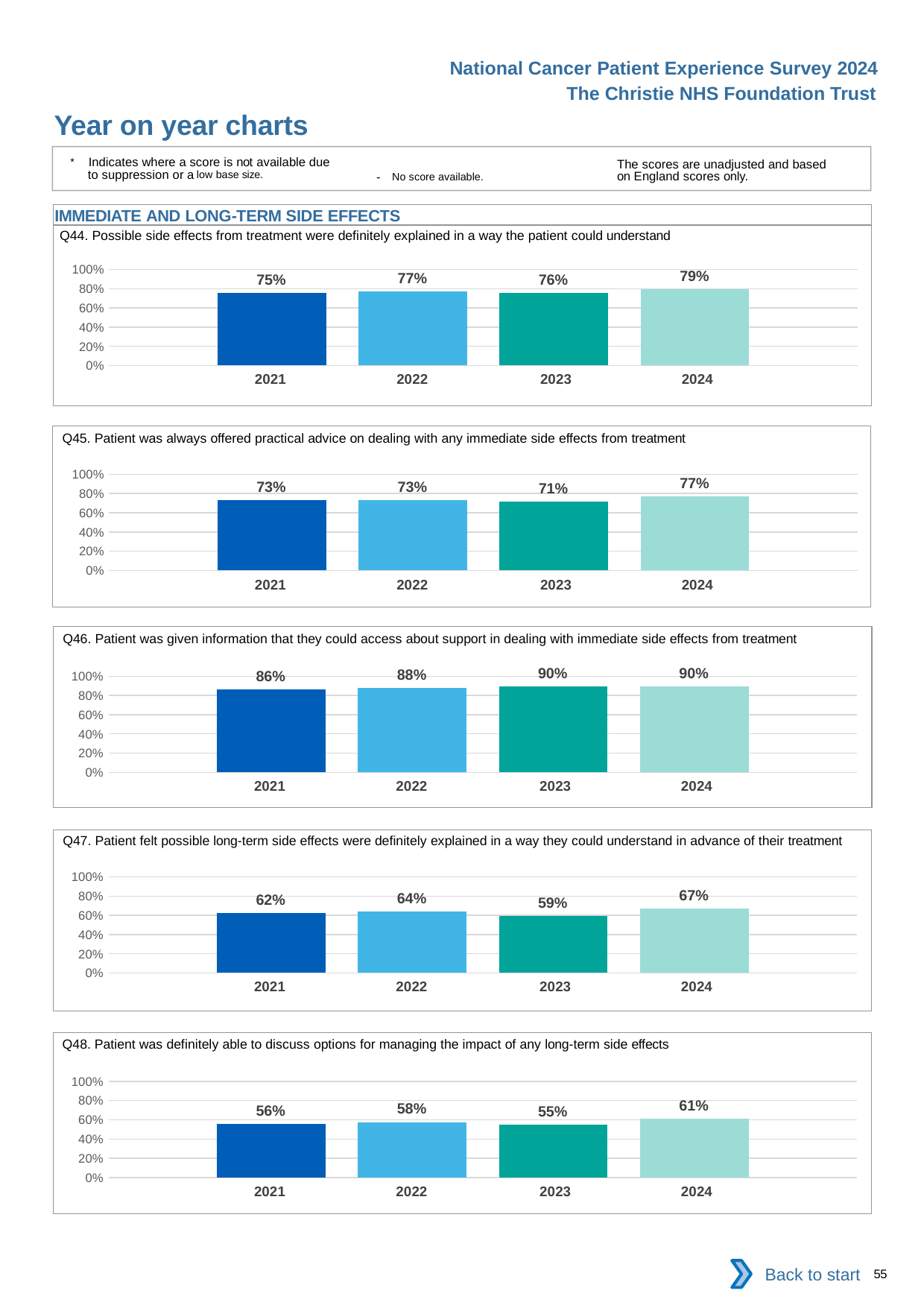
In the Q46 chart, is the value for 2021 greater or less than 80%? greater In the Q44 chart, what is the value for 2024? 79% How many years are shown in the Q44 chart? 4 In the Q45 chart, which year has the lowest value? 2023 In the Q48 chart, what is the value for 2022? 58% In the Q48 chart, what is the difference between the 2024 value and the 2023 value? 6% In the Q47 chart, is the value for 2023 larger or smaller than the value for 2022? smaller What is the section heading above the Q44 chart? IMMEDIATE AND LONG-TERM SIDE EFFECTS In the Q46 chart, what is the difference between the 2024 value and the 2021 value? 4% In the Q45 chart, what is the value for 2021? 73% In the Q47 chart, which year has the highest value? 2024 What kind of chart is the Q45 chart? bar chart